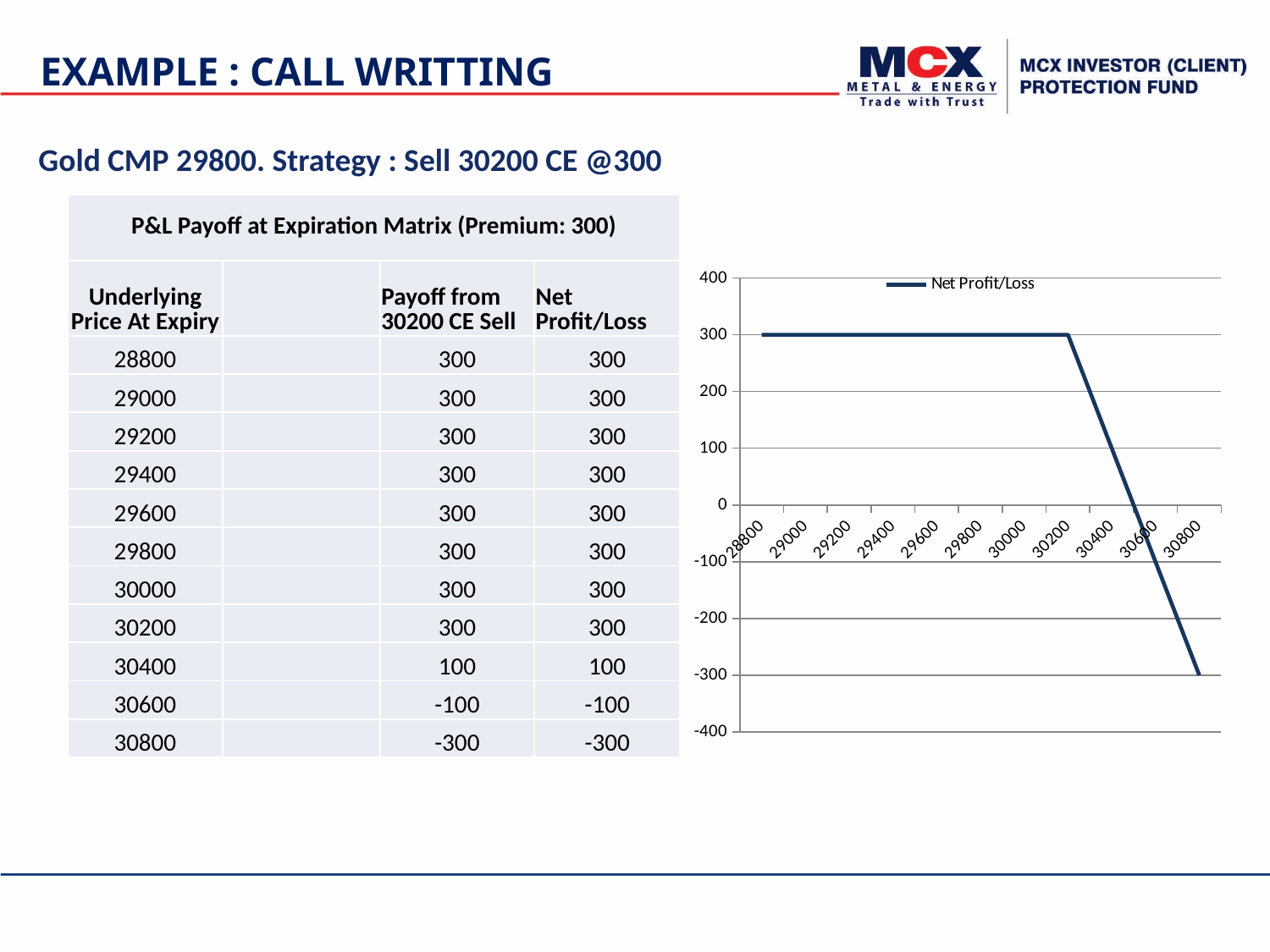
Is the Net Profit/Loss at 30600 greater or less than 0? less What kind of chart is shown on the slide? line chart What is the name of the series shown in the chart legend? Net Profit/Loss What is the difference between the Net Profit/Loss at 30200 and at 30800? 600 What is the Net Profit/Loss value at an underlying price of 30800? -300 Which is larger, the Net Profit/Loss at 30200 or at 30600? 30200 How many series does the chart legend list? 1 How many underlying price points are plotted along the x axis of the chart? 11 Does the Net Profit/Loss line rise or fall as the underlying price moves from 30200 to 30800? fall What is the Net Profit/Loss value at an underlying price of 30400? 100 What is the Net Profit/Loss value at an underlying price of 29400? 300 At which underlying price is the Net Profit/Loss lowest? 30800